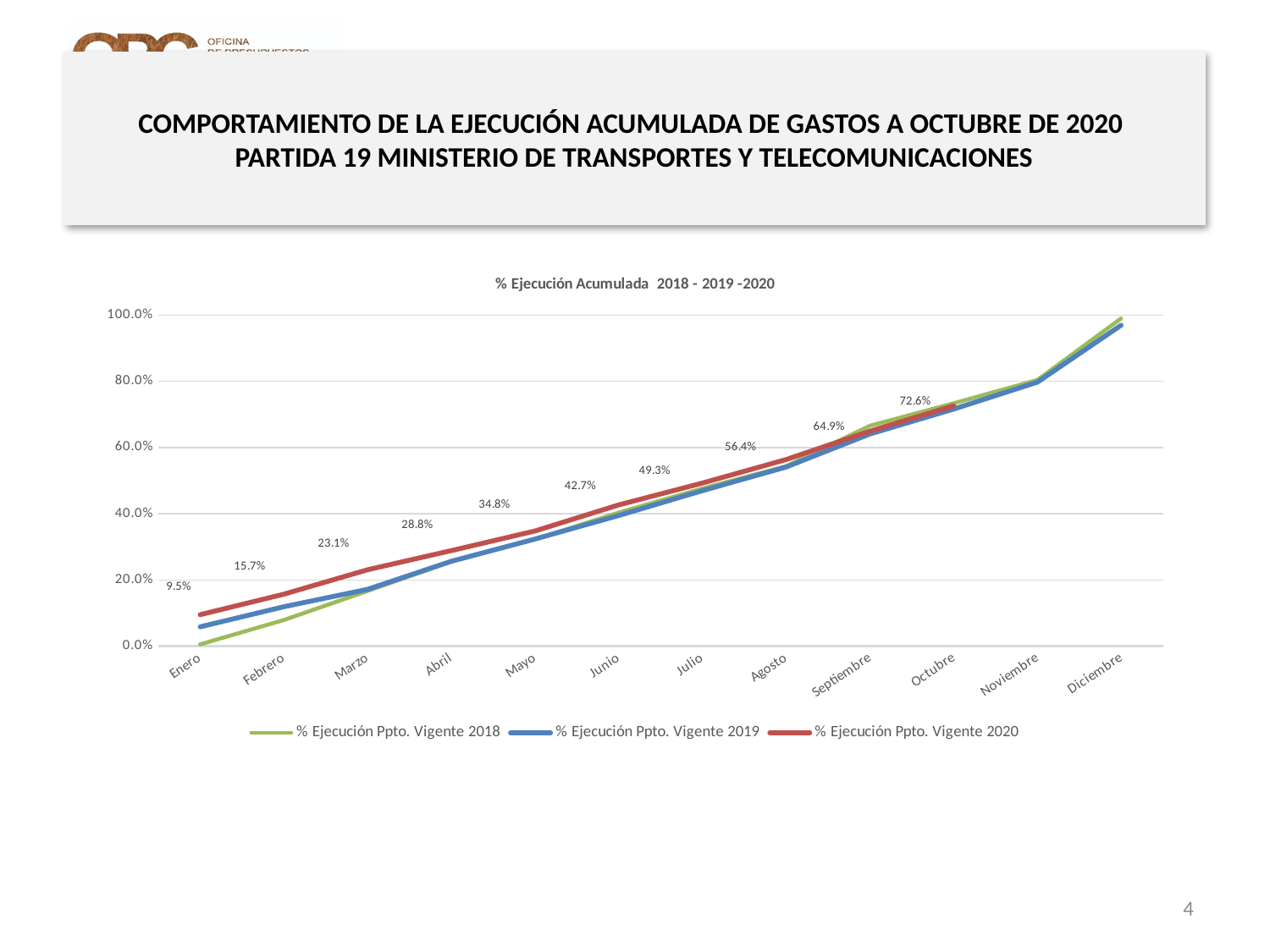
Which month has the lowest labelled value for % Ejecución Ppto. Vigente 2020? Enero What kind of chart is shown on the slide? Line chart What is the value of % Ejecución Ppto. Vigente 2020 for Enero? 9.5% What is the difference between the % Ejecución Ppto. Vigente 2020 values for Octubre and Septiembre? 7.7% How many months are shown on the x axis of the chart? 12 What is the value of % Ejecución Ppto. Vigente 2020 for Octubre? 72.6% Which month has the highest labelled value for % Ejecución Ppto. Vigente 2020? Octubre What is the value of % Ejecución Ppto. Vigente 2020 for Junio? 42.7% How many series does the chart legend list? 3 Is the value of % Ejecución Ppto. Vigente 2018 for Enero greater or less than 20.0%? less Is the % Ejecución Ppto. Vigente 2020 value for Agosto greater or less than the value for Julio? greater What is the value of % Ejecución Ppto. Vigente 2020 for Septiembre? 64.9%